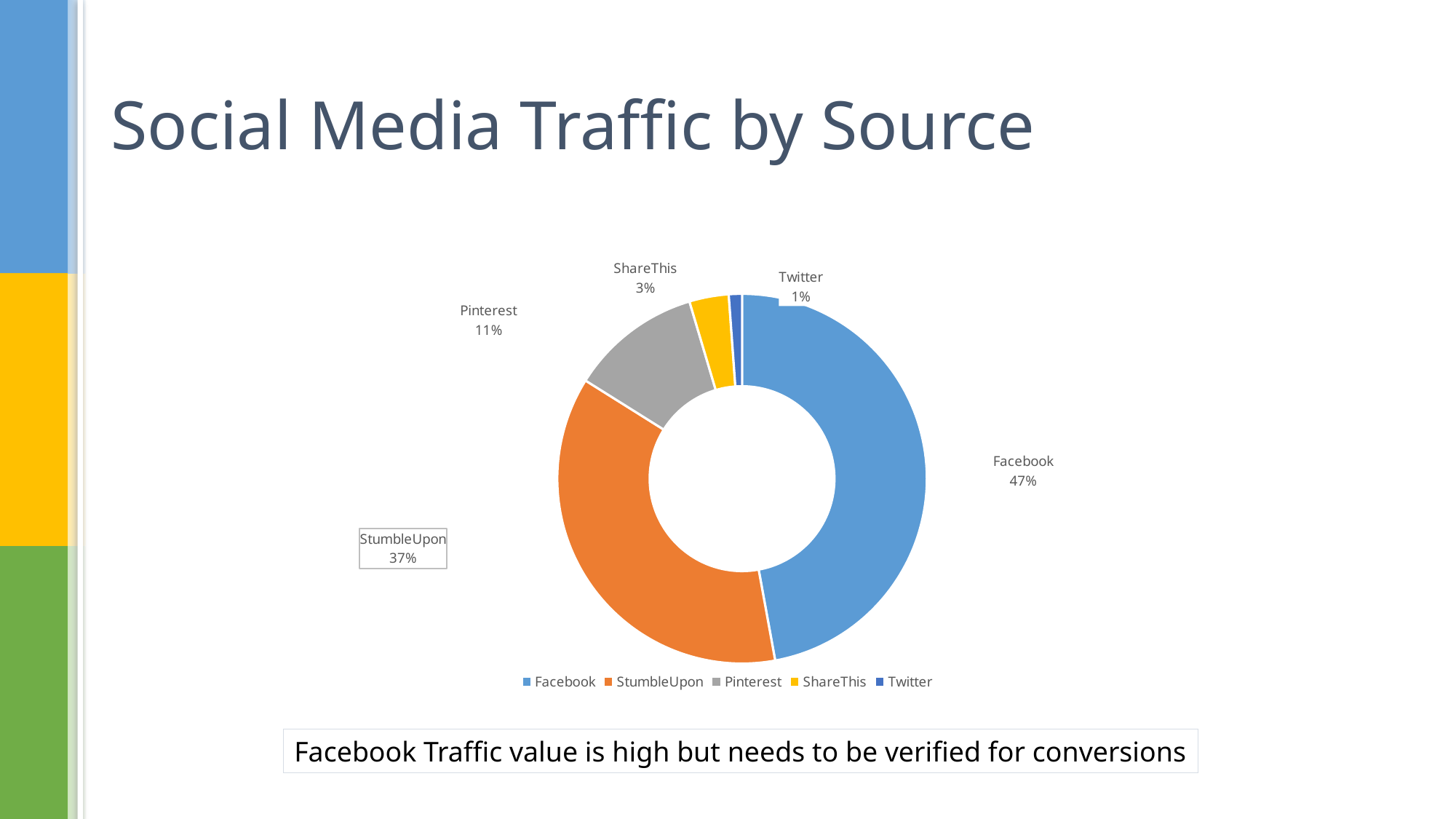
What share of social media traffic comes from StumbleUpon? 37% What share of social media traffic comes from ShareThis? 3% What share of social media traffic comes from Facebook? 47% What kind of chart is shown on the slide? Doughnut chart Which has a larger share of traffic, Pinterest or ShareThis? Pinterest What share of social media traffic comes from Pinterest? 11% What colour represents StumbleUpon in the chart? Orange How many traffic sources are shown in the chart? 5 What is the combined share of Facebook and StumbleUpon? 84% Which source has the smallest share of social media traffic? Twitter Which source has the largest share of social media traffic? Facebook How many percentage points larger is Facebook's share than StumbleUpon's? 10